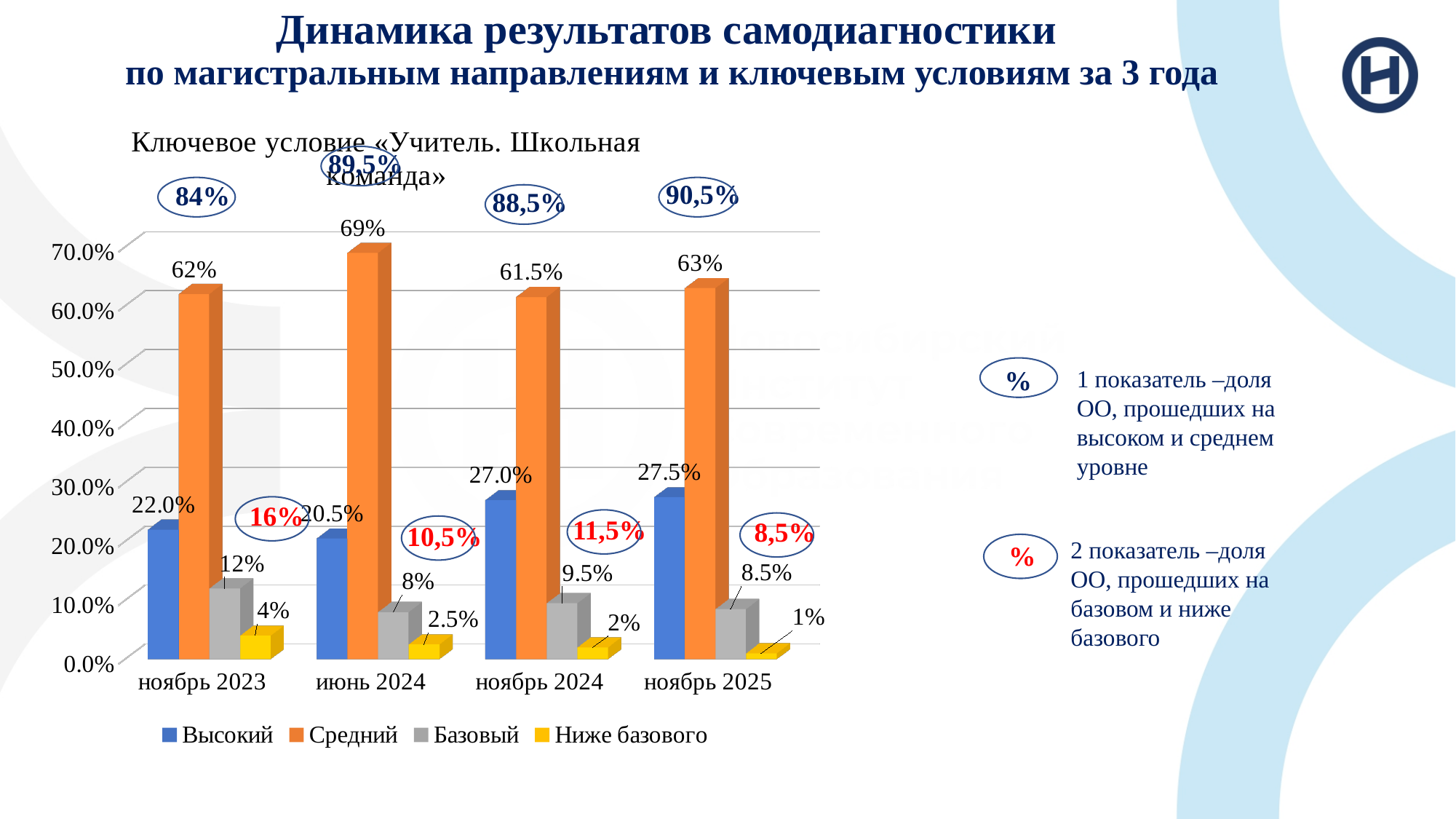
What is the difference between the Базовый values in ноябрь 2023 and июнь 2024? 4% Which is larger: the Высокий value in ноябрь 2023 or in июнь 2024? ноябрь 2023 In which category is the Ниже базового value lowest? ноябрь 2025 How many categories are shown on the x axis? 4 What is the value for Базовый in ноябрь 2024? 9.5% In which category is the Средний value highest? июнь 2024 What kind of chart is shown on the slide? bar chart How many series does the legend list? 4 What is the value for Средний in июнь 2024? 69% What is the value for Высокий in ноябрь 2025? 27.5% What is the value for Ниже базового in ноябрь 2023? 4% Which series is shown in orange in the legend? Средний